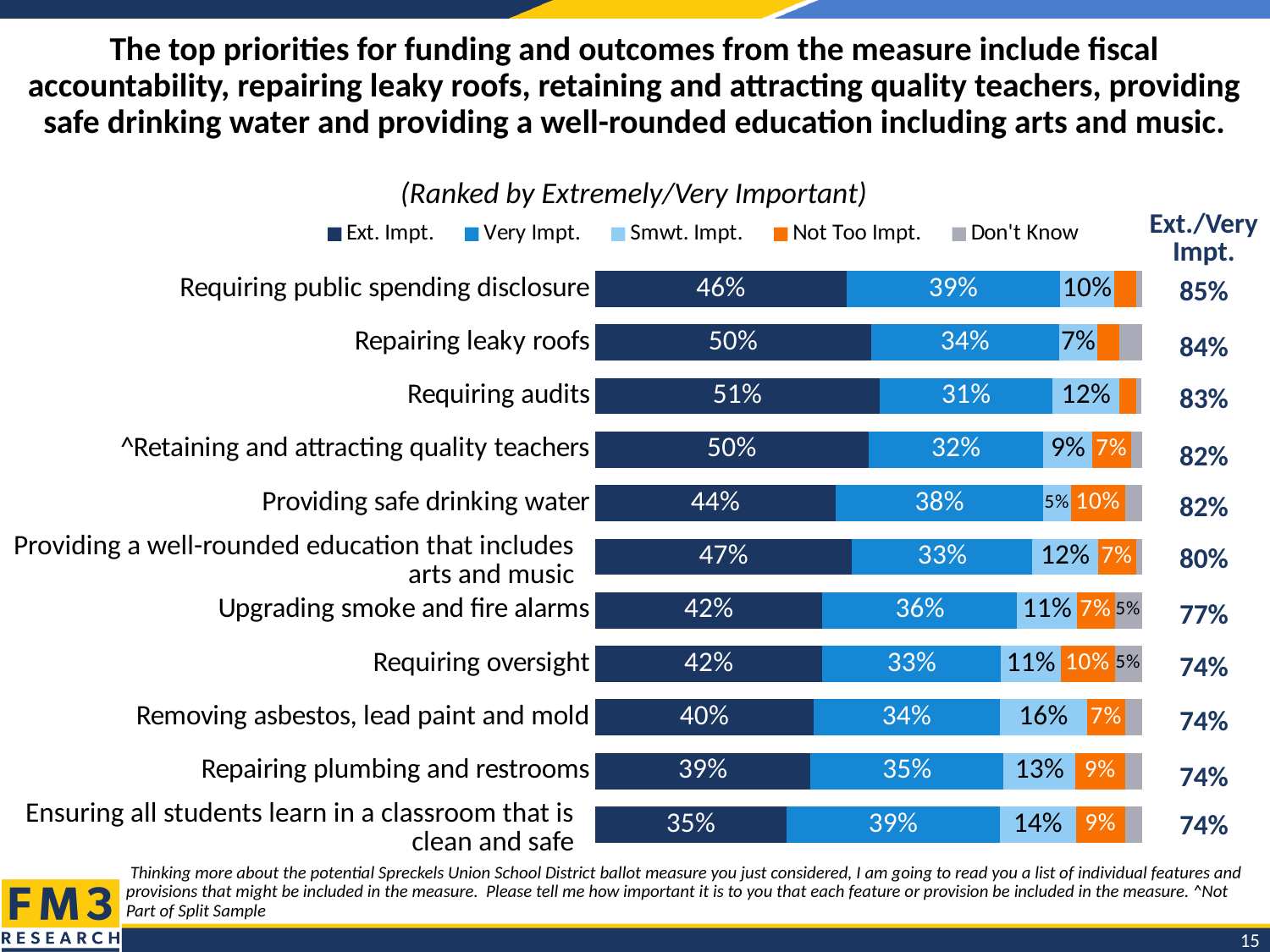
Which category has the highest Ext./Very Impt. value? Requiring public spending disclosure How many series does the chart legend list? 5 What kind of chart is shown on the slide? Stacked bar chart What is the difference in Ext. Impt. between "Requiring audits" and "Ensuring all students learn in a classroom that is clean and safe"? 16 percentage points Which has the larger Very Impt. value: "Requiring public spending disclosure" or "Repairing leaky roofs"? Requiring public spending disclosure What is the Very Impt. value for "Providing safe drinking water"? 38% What is the Ext./Very Impt. value for "Repairing leaky roofs"? 84% How many categories (features or provisions) are plotted in the chart? 11 What is the Ext. Impt. value for "Requiring audits"? 51% Which category has the highest Ext. Impt. value? Requiring audits What is the Smwt. Impt. value for "Removing asbestos, lead paint and mold"? 16% Which category has the lowest Ext. Impt. value? Ensuring all students learn in a classroom that is clean and safe